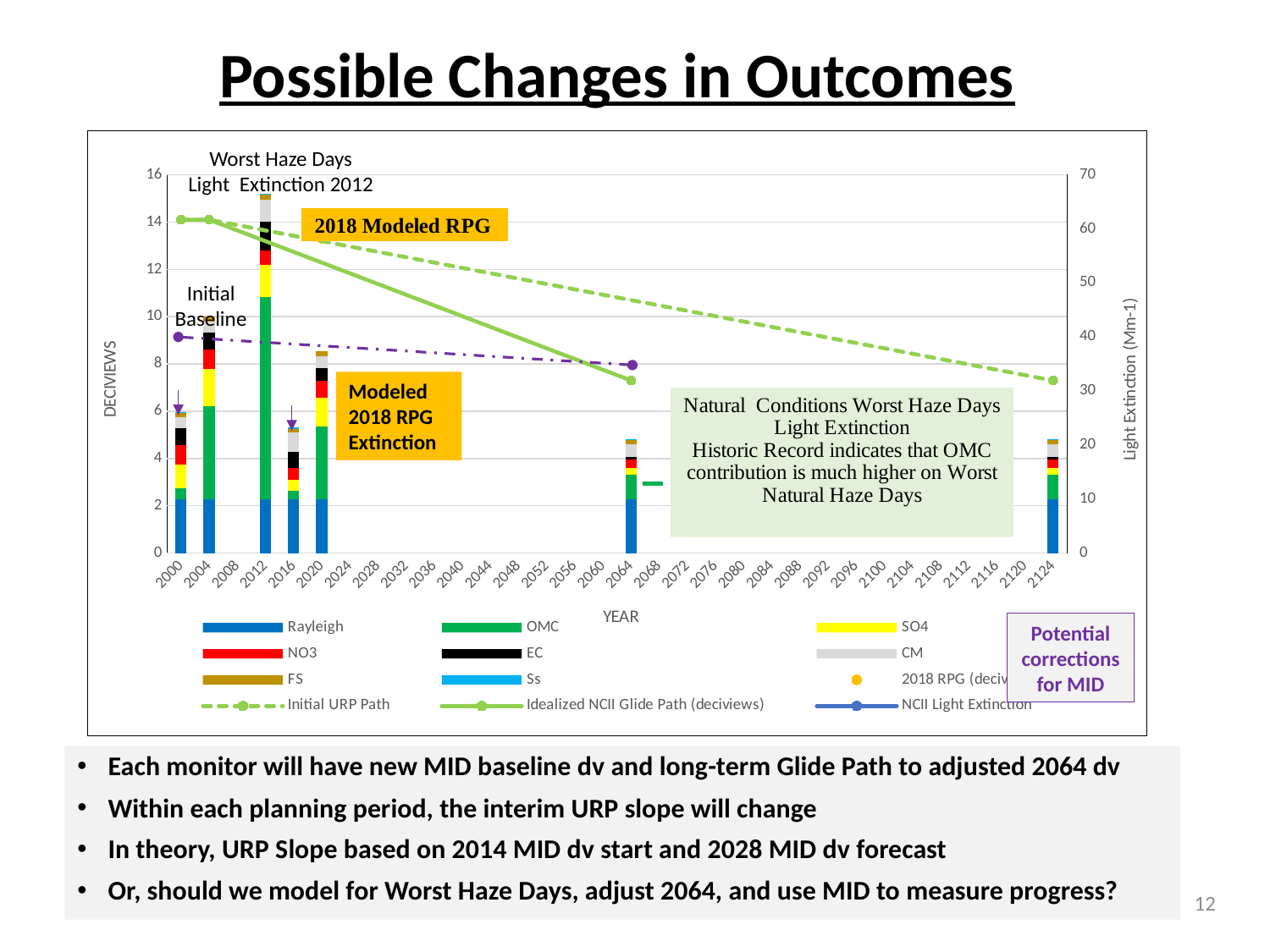
Which stacked bar is taller, 2004 or 2016? 2004 On the left DECIVIEWS axis, is the Initial URP Path value at 2124 greater or less than 10? less How many series does the chart legend list? 12 What kind of chart is shown on the slide? A combined stacked bar and line chart Does the Idealized NCII Glide Path line rise or fall from 2004 to 2064? Fall Which stacked bar is taller, 2012 or 2020? 2012 How many stacked bars are plotted on the chart? 7 Does the Initial URP Path line rise or fall from 2000 to 2124? Fall What is the title of the right vertical axis? Light Extinction (Mm-1) What is the title of the left vertical axis? DECIVIEWS On the left DECIVIEWS axis, is the Initial URP Path value at 2000 greater or less than 12? greater Which year has the tallest stacked bar? 2012